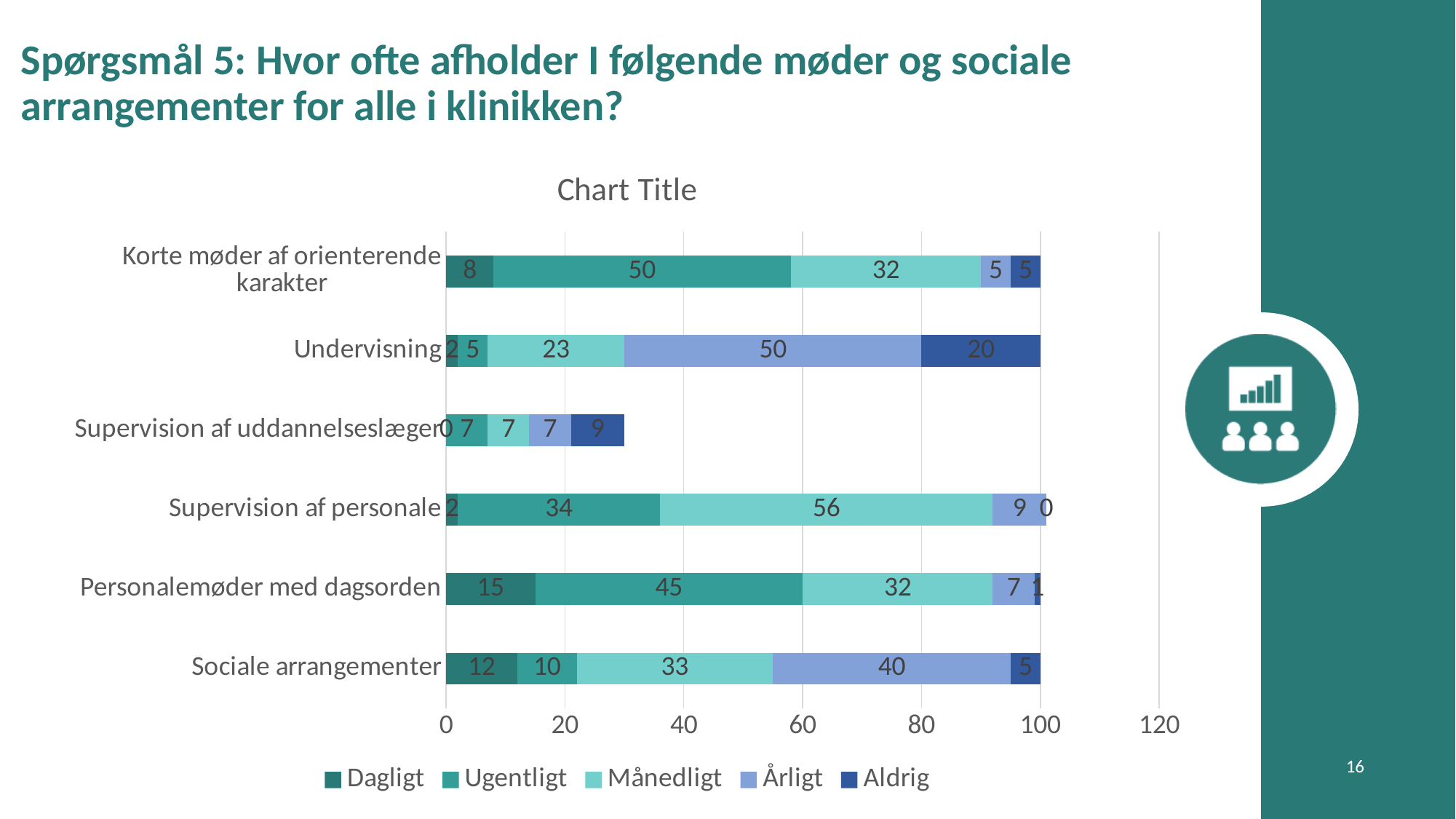
What is the Aldrig value for Supervision af uddannelseslæger? 9 What is the Årligt value for Undervisning? 50 What is the Månedligt value for Supervision af personale? 56 What is the total of the stacked bar for Supervision af uddannelseslæger? 30 What is the Ugentligt value for Korte møder af orienterende karakter? 50 Which category has the shortest total stacked bar? Supervision af uddannelseslæger How many categories are plotted on the chart? 6 What is the Dagligt value for Personalemøder med dagsorden? 15 Which category has the highest Dagligt value? Personalemøder med dagsorden How many series does the legend list? 5 What kind of chart is shown on the slide? stacked bar chart What is the difference between the Årligt value for Sociale arrangementer and the Årligt value for Personalemøder med dagsorden? 33